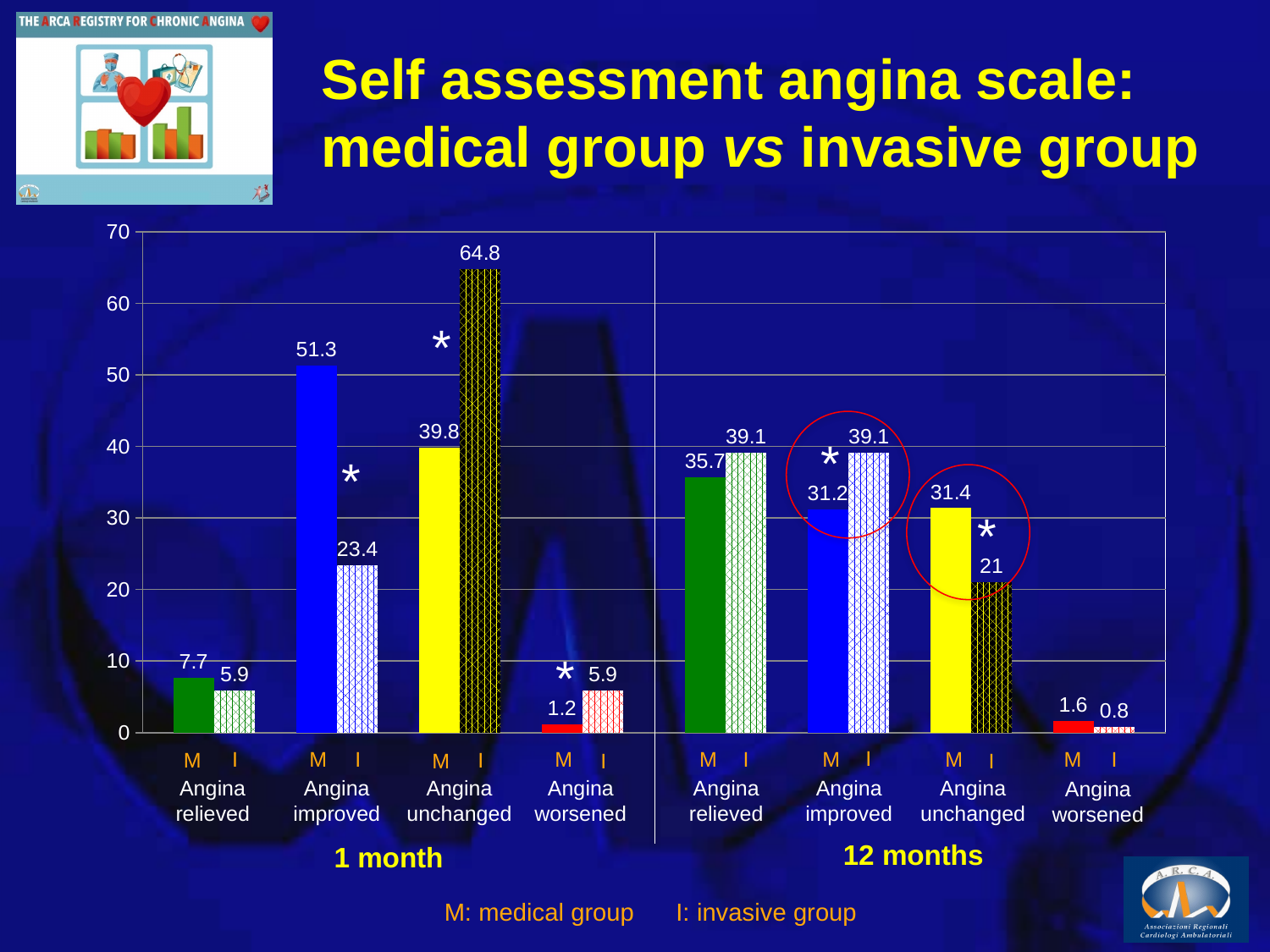
What is the difference between the invasive group (I) and medical group (M) values for Angina unchanged at 12 months? 10.4 Which bar has the lowest value on the chart? Angina worsened, invasive group (I), 12 months Which bar has the highest value on the chart? Angina unchanged, invasive group (I), 1 month What do the labels M and I stand for in the chart? M: medical group; I: invasive group What is the difference between the medical group (M) and invasive group (I) values for Angina improved at 1 month? 27.9 Is the value for the medical group (M) for Angina unchanged at 1 month greater or less than 30? greater What is the value for the invasive group (I) for Angina unchanged at 12 months? 21 What is the value for the invasive group (I) for Angina unchanged at 1 month? 64.8 What type of chart is shown on the slide? Bar chart What is the value for the medical group (M) for Angina improved at 1 month? 51.3 At 12 months, which is larger for Angina relieved: the medical group (M) or the invasive group (I)? Invasive group (I) What is the value for the medical group (M) for Angina worsened at 12 months? 1.6